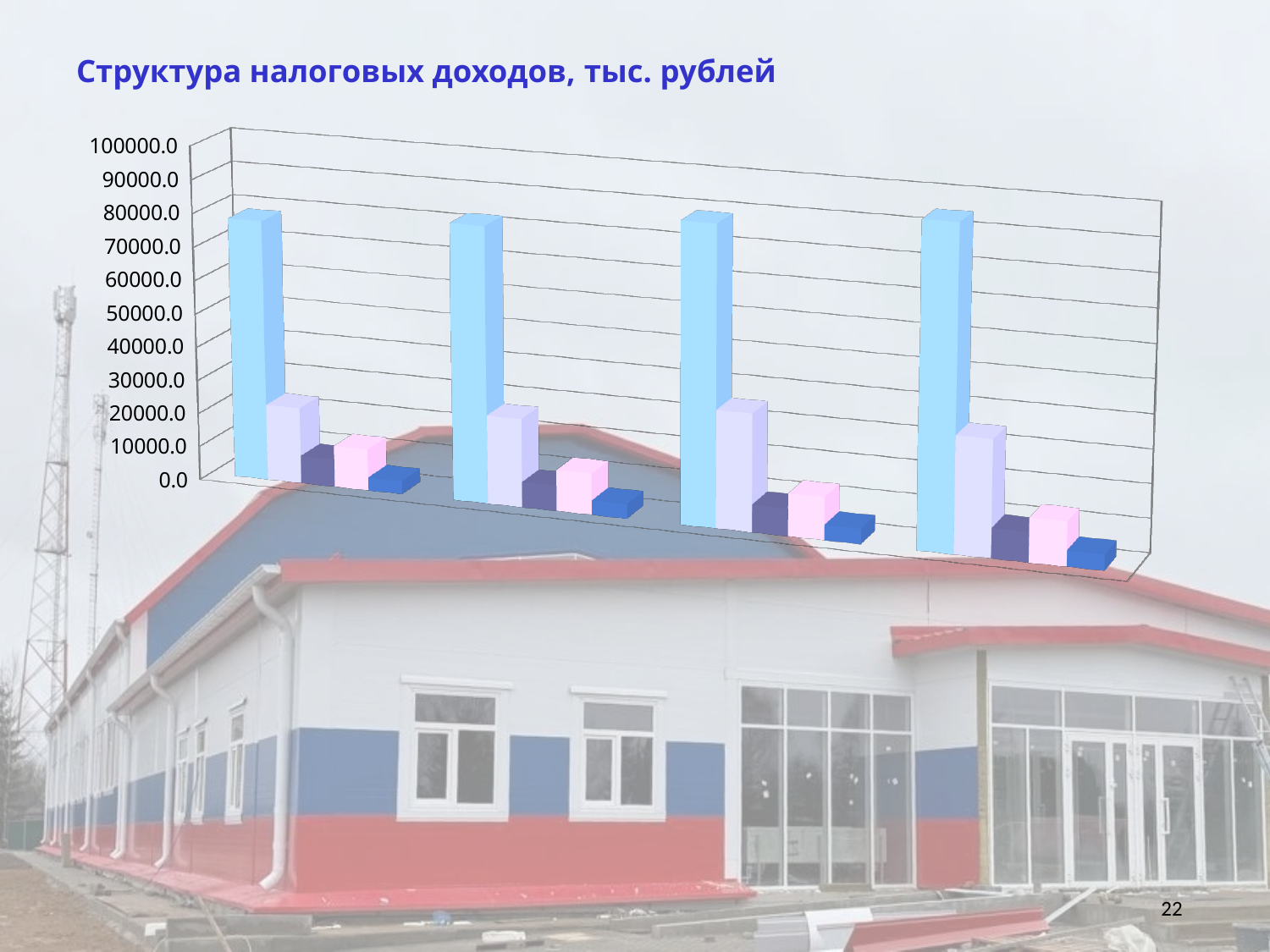
How many bars are there in each group of the chart? 5 Is the value of the dark blue (last) bar in the first group greater or less than 30000? less Which bar colour represents the smallest value in every group of the chart? dark blue What is the highest value shown on the vertical axis of the chart? 100000.0 Is the value of the tallest (light blue) bar in the first group greater or less than 50000? greater Is the value of the light blue bar in the fourth group greater or less than 60000? greater What is the title of the chart? Структура налоговых доходов, тыс. рублей In the first group, which is larger: the light blue bar or the lavender bar? the light blue bar What kind of chart is shown on the slide? bar chart How many groups of bars are plotted in the chart? 4 Which bar colour represents the largest value in every group of the chart? light blue